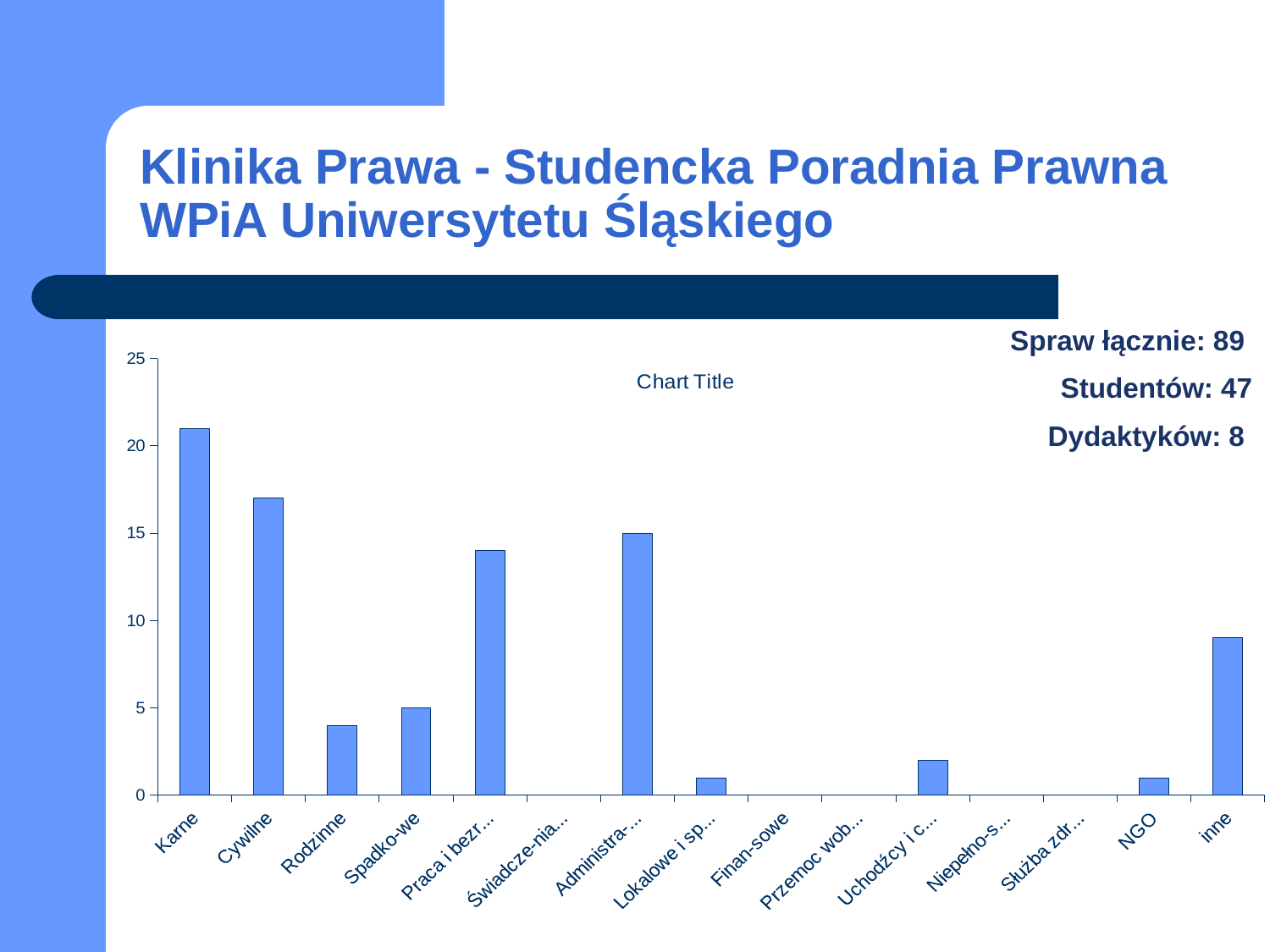
Is the value for Praca i bezr... greater or less than 10? greater How many categories are shown on the x axis of the chart? 15 Is the value for Administra-... greater or less than 10? greater Is the value for Uchodźcy i c... greater or less than 5? less Which category has the highest bar in the chart? Karne Which is larger, the value for Karne or the value for Cywilne? Karne What kind of chart is shown on the slide? bar chart What is the title shown on the chart? Chart Title